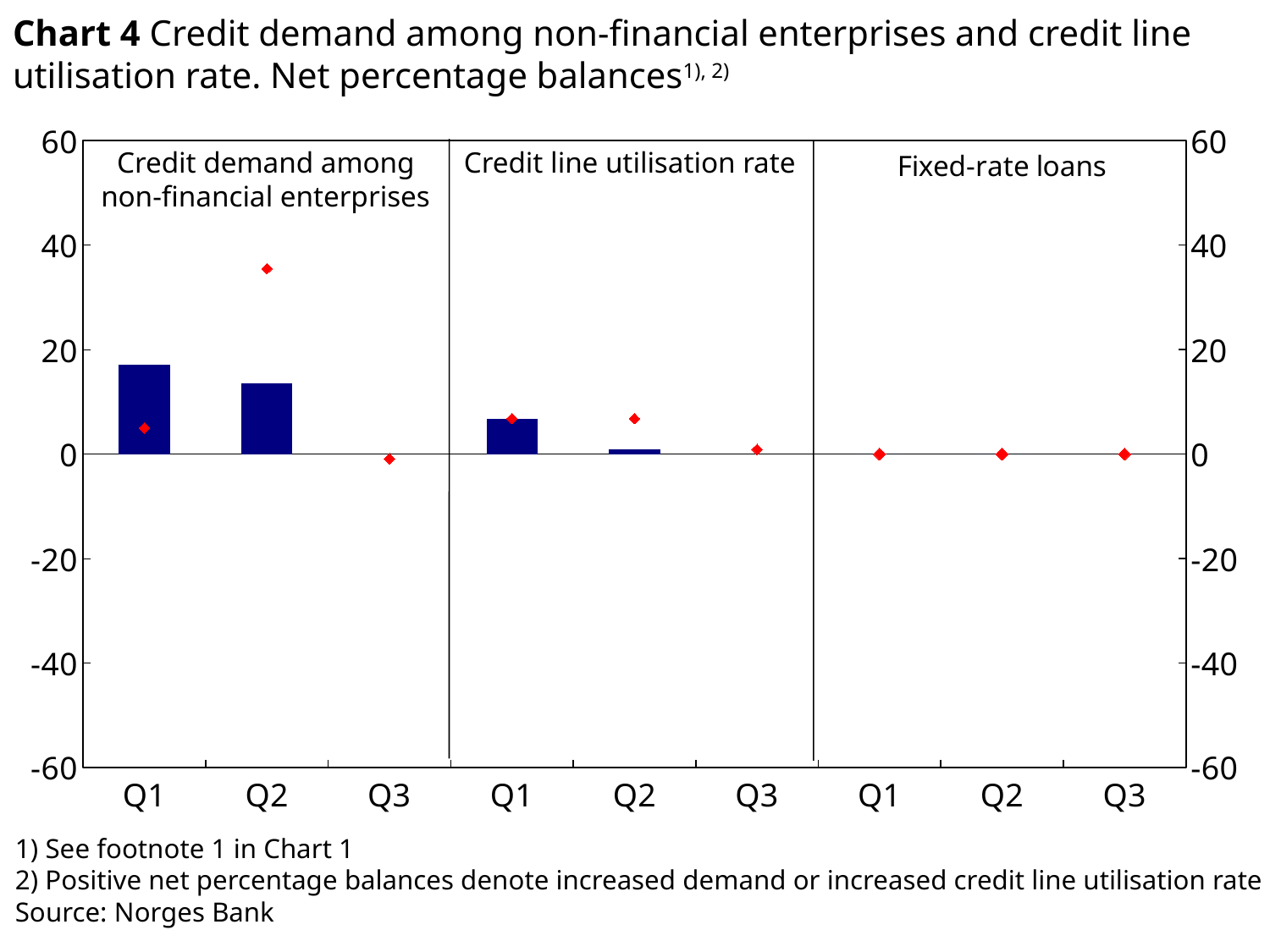
In the 'Credit line utilisation rate' panel, is the Q1 bar greater or less than 20? less In the 'Credit line utilisation rate' panel, which quarter has the tallest bar? Q1 In the 'Credit demand among non-financial enterprises' panel, is the Q1 bar greater or less than 20? less In the 'Credit demand among non-financial enterprises' panel, which quarter has the tallest bar? Q1 How many quarters are shown in each panel of the chart? 3 What is the highest value shown on the vertical axis? 60 In the 'Credit demand among non-financial enterprises' panel, is the red marker for Q2 greater or less than 40? less What kind of chart is shown on the slide? combination bar and line chart (bars with red diamond markers) In the 'Credit demand among non-financial enterprises' panel, do the bars rise or fall from Q1 to Q3? fall What is the label of the middle panel of the chart? Credit line utilisation rate In the 'Credit demand among non-financial enterprises' panel, which bar is larger, Q1 or Q2? Q1